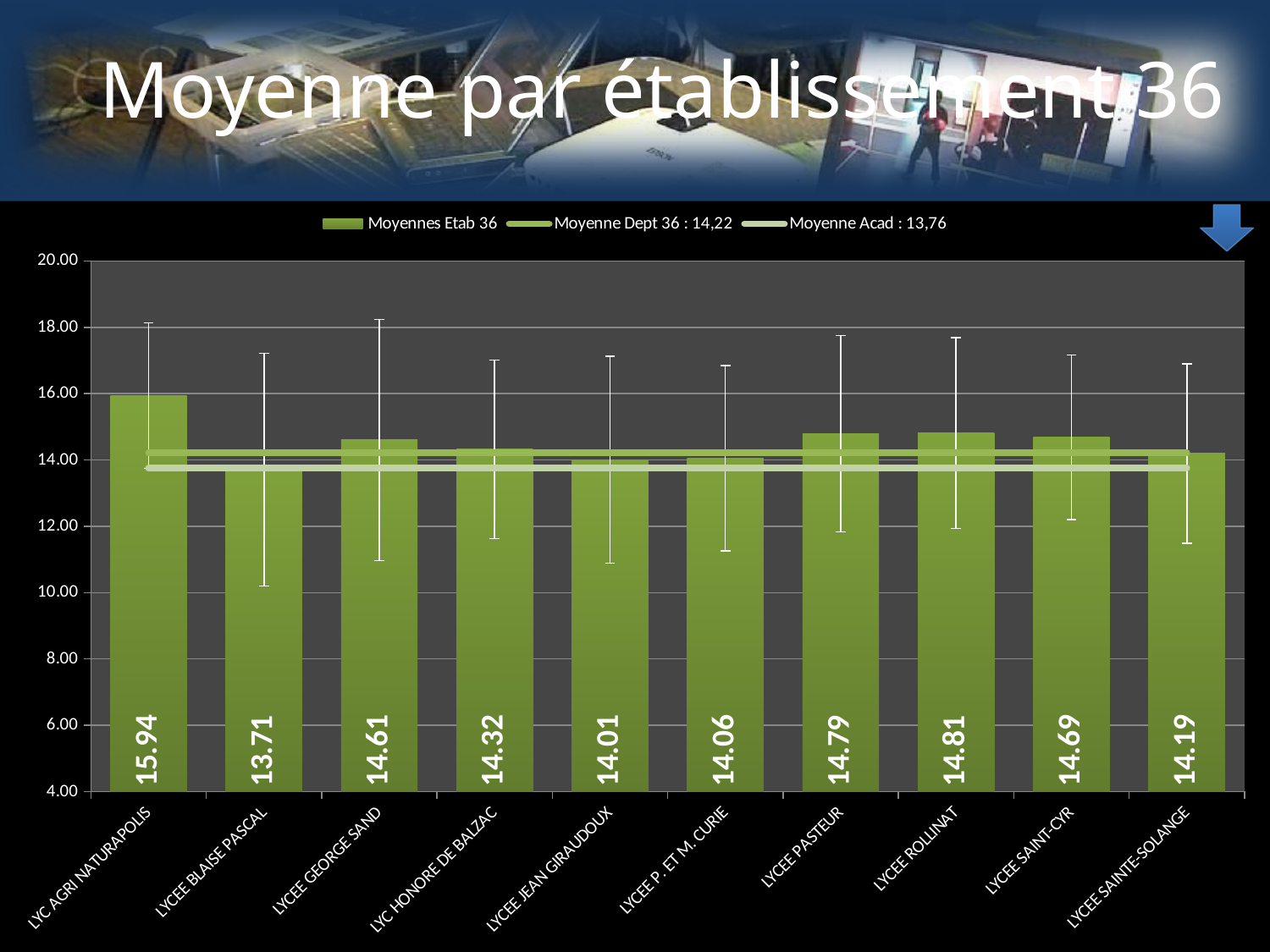
Is the value for LYCEE BLAISE PASCAL greater or less than 14.00? less What kind of chart is shown on the slide? bar chart What is the value for LYCEE SAINTE-SOLANGE? 14.19 What is the difference between the values for LYC AGRI NATURAPOLIS and LYCEE BLAISE PASCAL? 2.23 Which establishment has the lowest value? LYCEE BLAISE PASCAL How many establishments are shown on the x axis? 10 How many entries does the legend list? 3 Which establishment has the highest value? LYC AGRI NATURAPOLIS What is the value for LYCEE ROLLINAT? 14.81 Which has the larger value, LYCEE GEORGE SAND or LYC HONORE DE BALZAC? LYCEE GEORGE SAND What is the value for LYC AGRI NATURAPOLIS? 15.94 According to the legend, what is the value of Moyenne Dept 36? 14,22